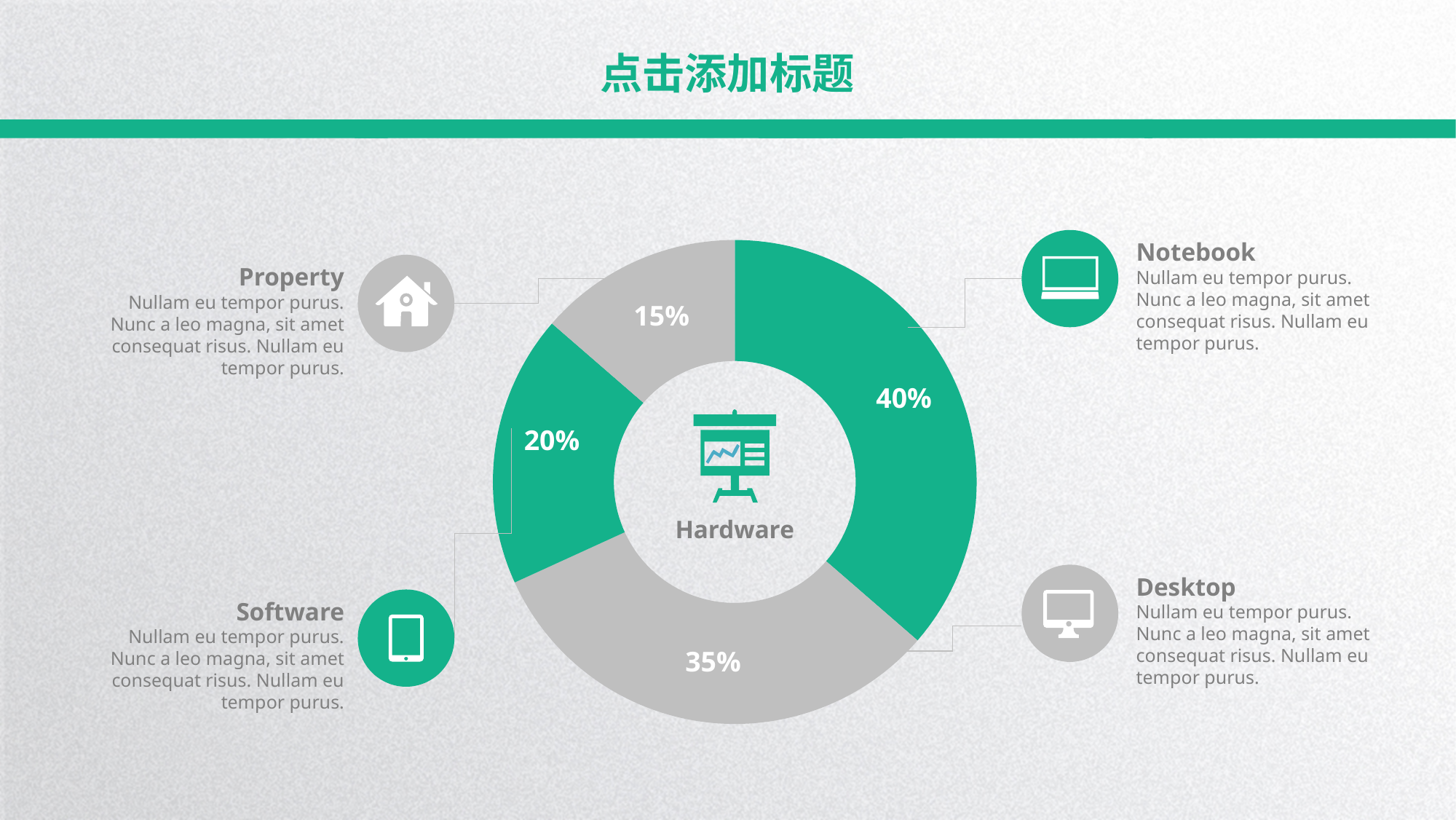
What kind of chart is shown on the slide? Donut (pie) chart What percentage is shown for the Property slice? 15% Which category has the largest slice of the chart? Notebook Which slice is larger, Software or Property? Software What percentage is shown for the Notebook slice? 40% What label appears in the centre of the donut chart? Hardware Which category has the smallest slice of the chart? Property How many slices does the chart have? 4 What colour is the Desktop slice of the chart? Gray What is the difference in percentage points between the Notebook and Desktop slices? 5% What percentage is shown for the Desktop slice? 35% What percentage is shown for the Software slice? 20%